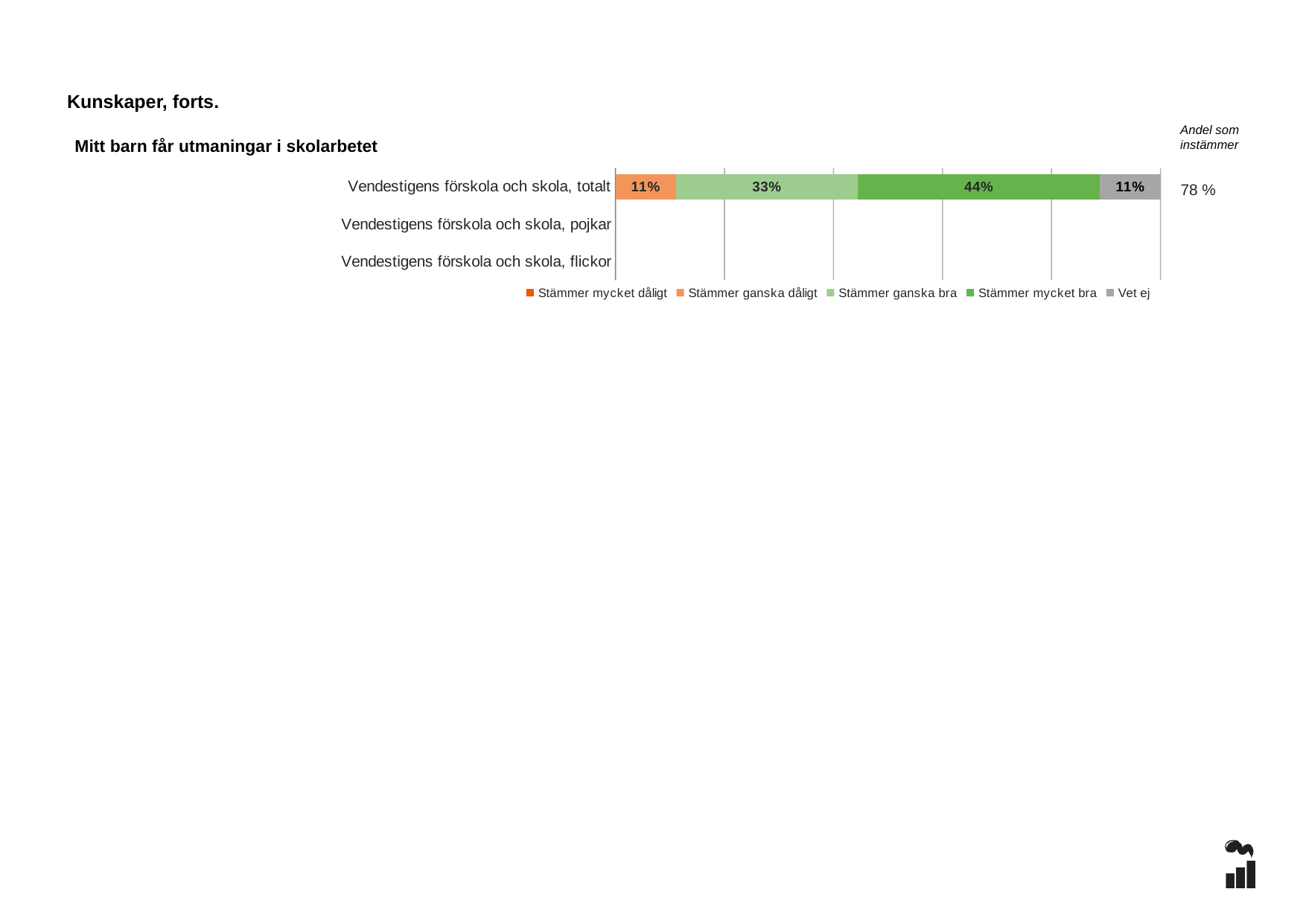
What is the value for "Stämmer ganska dåligt" in the "Vendestigens förskola och skola, totalt" bar? 11% How many category rows are listed on the vertical axis of the chart? 3 What is the value for "Vet ej" in the "Vendestigens förskola och skola, totalt" bar? 11% Which is larger in the "Vendestigens förskola och skola, totalt" bar: "Stämmer ganska bra" or "Vet ej"? Stämmer ganska bra What is the title of the chart? Mitt barn får utmaningar i skolarbetet What is the value for "Stämmer mycket bra" in the "Vendestigens förskola och skola, totalt" bar? 44% What is the value for "Stämmer ganska bra" in the "Vendestigens förskola och skola, totalt" bar? 33% What is the difference between "Stämmer mycket bra" and "Stämmer ganska bra" in the "Vendestigens förskola och skola, totalt" bar? 11% How many series does the legend list? 5 Which response category has the largest share in the "Vendestigens förskola och skola, totalt" bar? Stämmer mycket bra What is the "Andel som instämmer" value shown for "Vendestigens förskola och skola, totalt"? 78 % What kind of chart is shown on the slide? Stacked bar chart